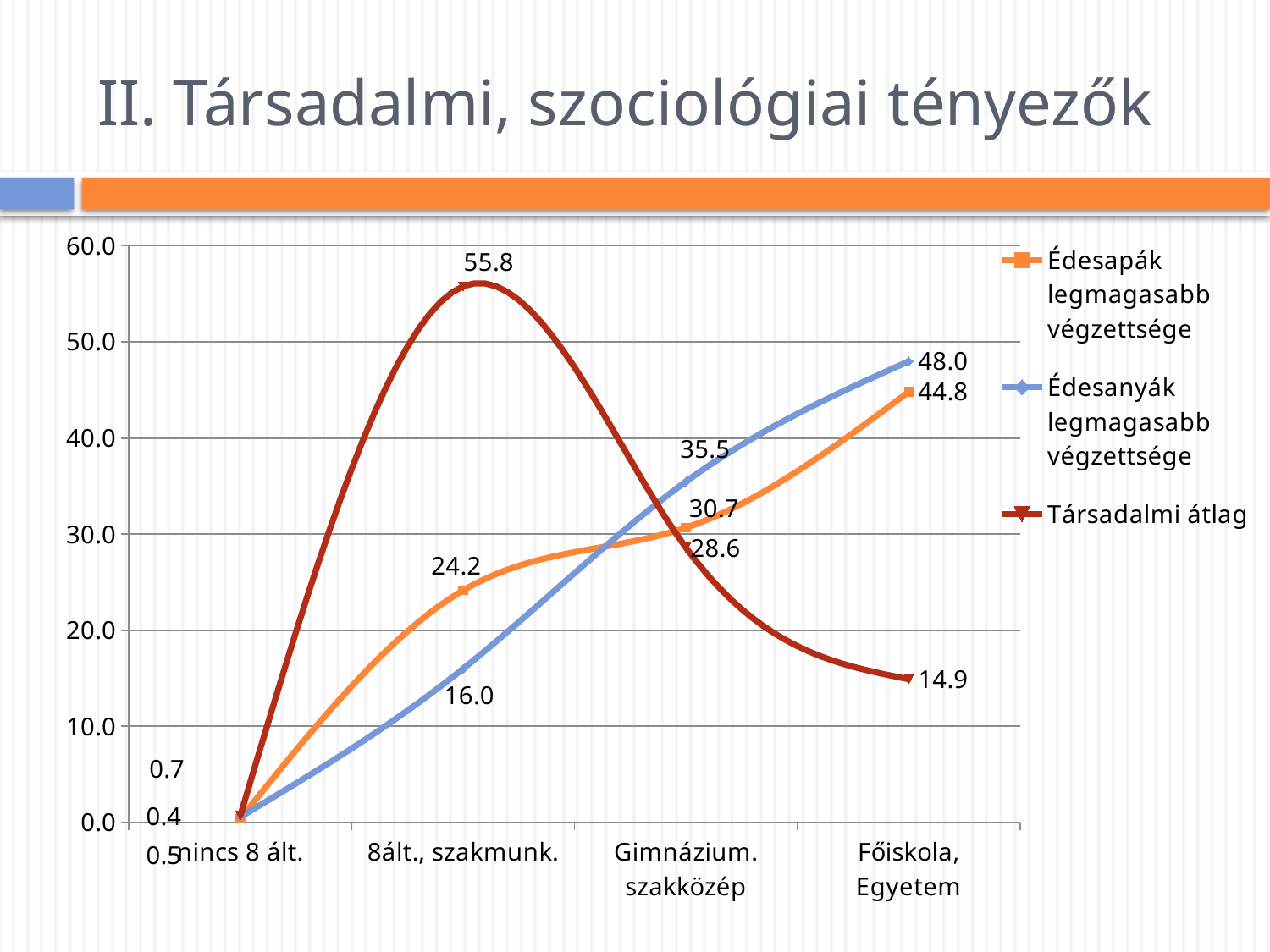
What type of chart is shown on the slide? line chart What is the value of Édesanyák legmagasabb végzettsége at Főiskola, Egyetem? 48.0 What is the value of Édesapák legmagasabb végzettsége at Gimnázium. szakközép? 30.7 What is the value of Társadalmi átlag at 8ált., szakmunk.? 55.8 Which series has the lowest value at Főiskola, Egyetem? Társadalmi átlag What is the value of Társadalmi átlag at Főiskola, Egyetem? 14.9 At which category does Társadalmi átlag reach its highest value? 8ált., szakmunk. At 8ált., szakmunk., which is larger: Édesapák legmagasabb végzettsége or Édesanyák legmagasabb végzettsége? Édesapák legmagasabb végzettsége Does Édesanyák legmagasabb végzettsége rise or fall from nincs 8 ált. to Főiskola, Egyetem? rise How many categories are shown on the x axis? 4 What is the difference between Édesanyák legmagasabb végzettsége and Édesapák legmagasabb végzettsége at Főiskola, Egyetem? 3.2 How many series does the legend list? 3